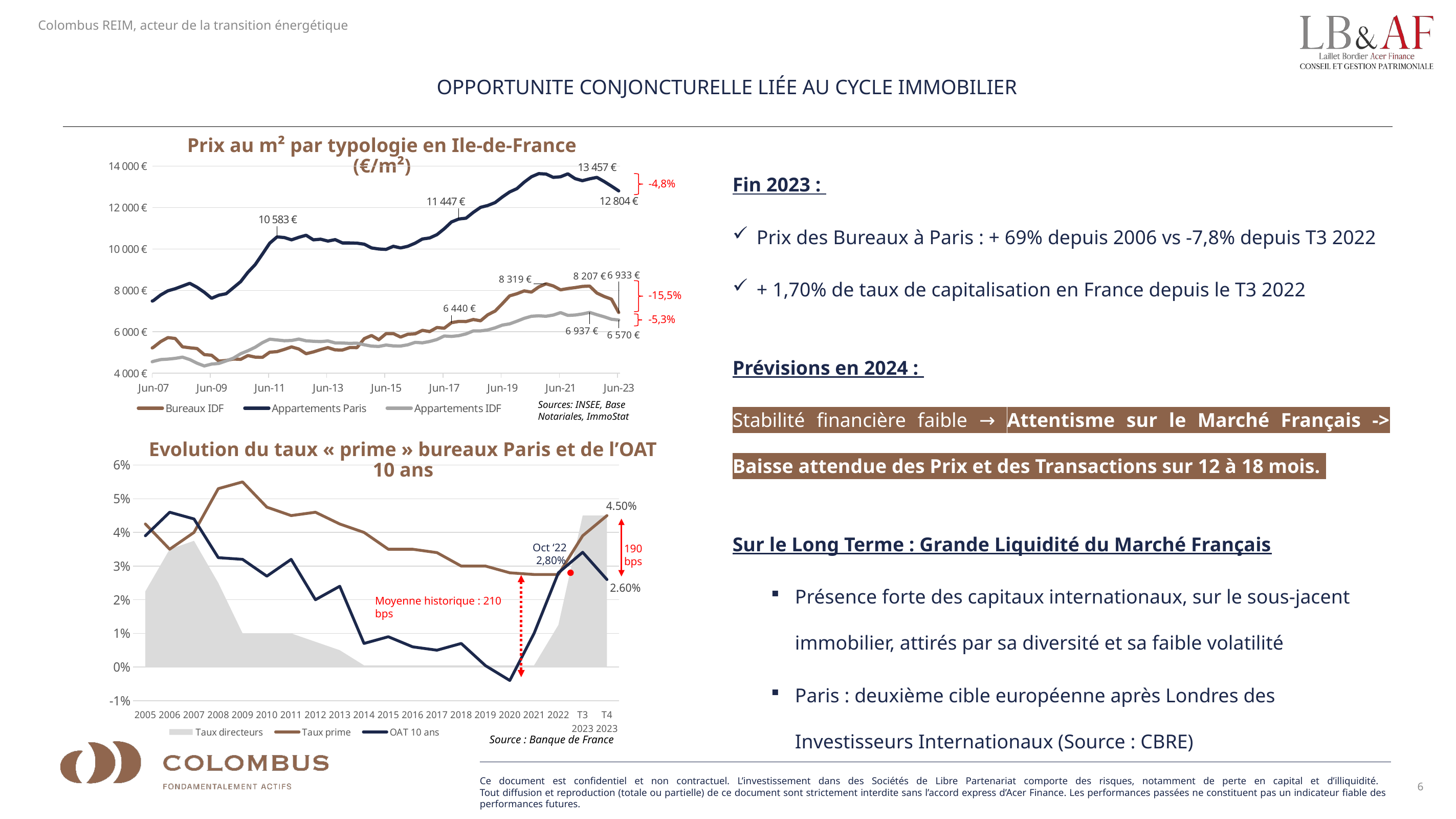
In the bottom chart 'Evolution du taux « prime » bureaux Paris et de l'OAT 10 ans', is the OAT 10 ans value in 2020 greater or less than 0%? less In the top chart 'Prix au m² par typologie en Ile-de-France', what percentage change is annotated in red for Bureaux IDF? -15,5% In the top chart 'Prix au m² par typologie en Ile-de-France', what is the peak value labelled for Bureaux IDF? 8 319 € In the bottom chart 'Evolution du taux « prime » bureaux Paris et de l'OAT 10 ans', how many series does the legend list? 3 In the top chart 'Prix au m² par typologie en Ile-de-France', how many series does the legend list? 3 What kind of chart is the top chart, 'Prix au m² par typologie en Ile-de-France'? line chart In the top chart 'Prix au m² par typologie en Ile-de-France', what is the peak value labelled for Appartements Paris? 13 457 € In the bottom chart 'Evolution du taux « prime » bureaux Paris et de l'OAT 10 ans', what is the Taux prime value labelled at T4 2023? 4.50% In the bottom chart 'Evolution du taux « prime » bureaux Paris et de l'OAT 10 ans', what is the OAT 10 ans value labelled at T4 2023? 2.60% In the top chart 'Prix au m² par typologie en Ile-de-France', what is the latest value labelled for Appartements Paris at Jun-23? 12 804 € In the top chart 'Prix au m² par typologie en Ile-de-France', what is the difference between the Appartements Paris peak of 13 457 € and the latest value of 12 804 €? 653 € In the top chart 'Prix au m² par typologie en Ile-de-France', which is higher at Jun-23: Bureaux IDF (6 933 €) or Appartements IDF (6 570 €)? Bureaux IDF